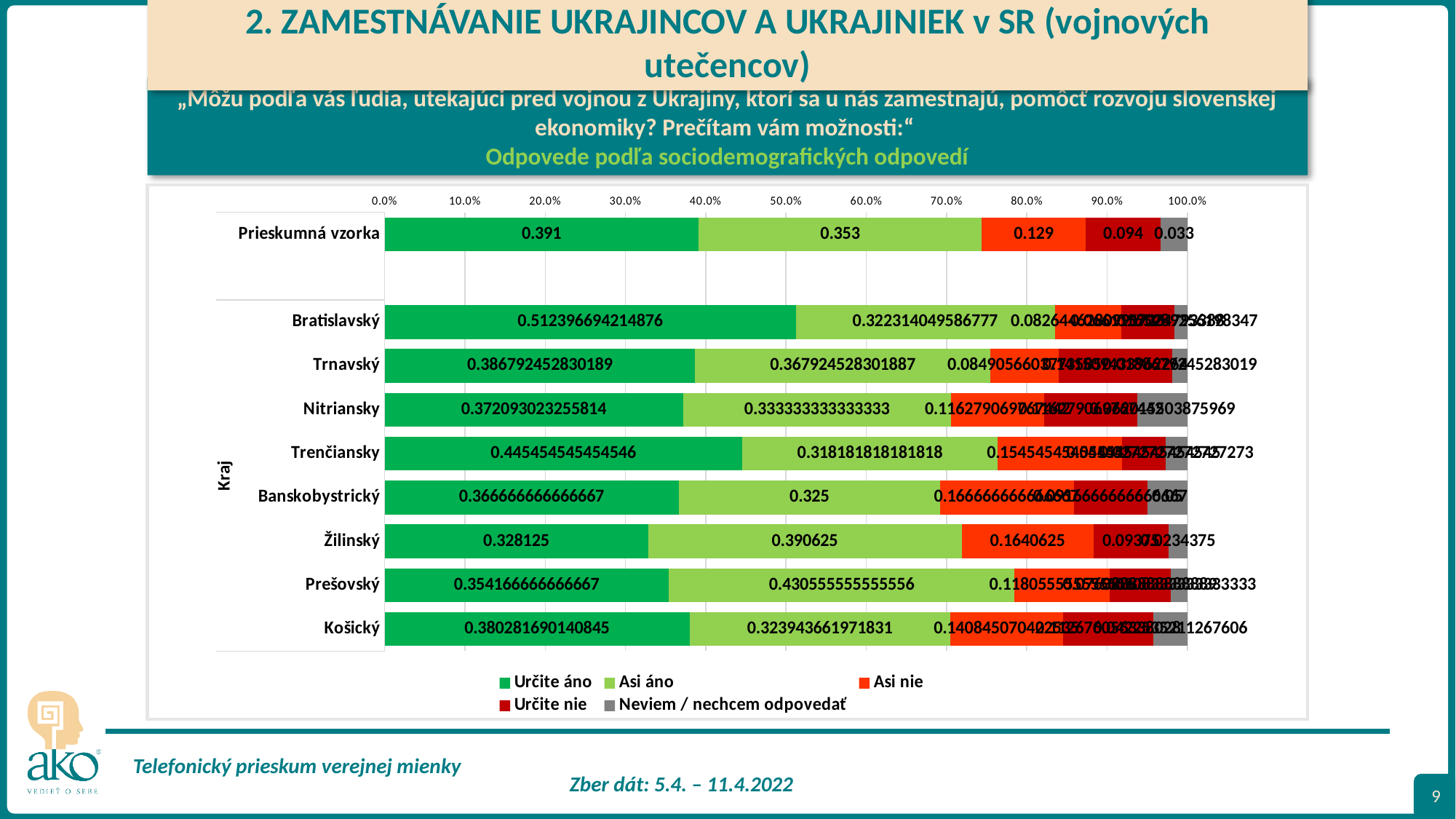
How many series does the legend list? 5 What is the value of Asi nie for Žilinský? 0.1640625 Which region has the highest value for Určite áno? Bratislavský How many regions (Kraj) are plotted below the Prieskumná vzorka bar? 8 Which region has the highest value for Asi áno? Prešovský What is the value of Asi áno for Banskobystrický? 0.325 Which region has the lowest value for Určite áno? Žilinský Which has the larger Určite áno value, Trenčiansky or Nitriansky? Trenčiansky What is the difference between Určite áno and Asi áno for Prieskumná vzorka? 0.038 What is the value of Určite áno for Prieskumná vzorka? 0.391 What is the value of Asi nie for Prieskumná vzorka? 0.129 What kind of chart is shown on the slide? Stacked bar chart